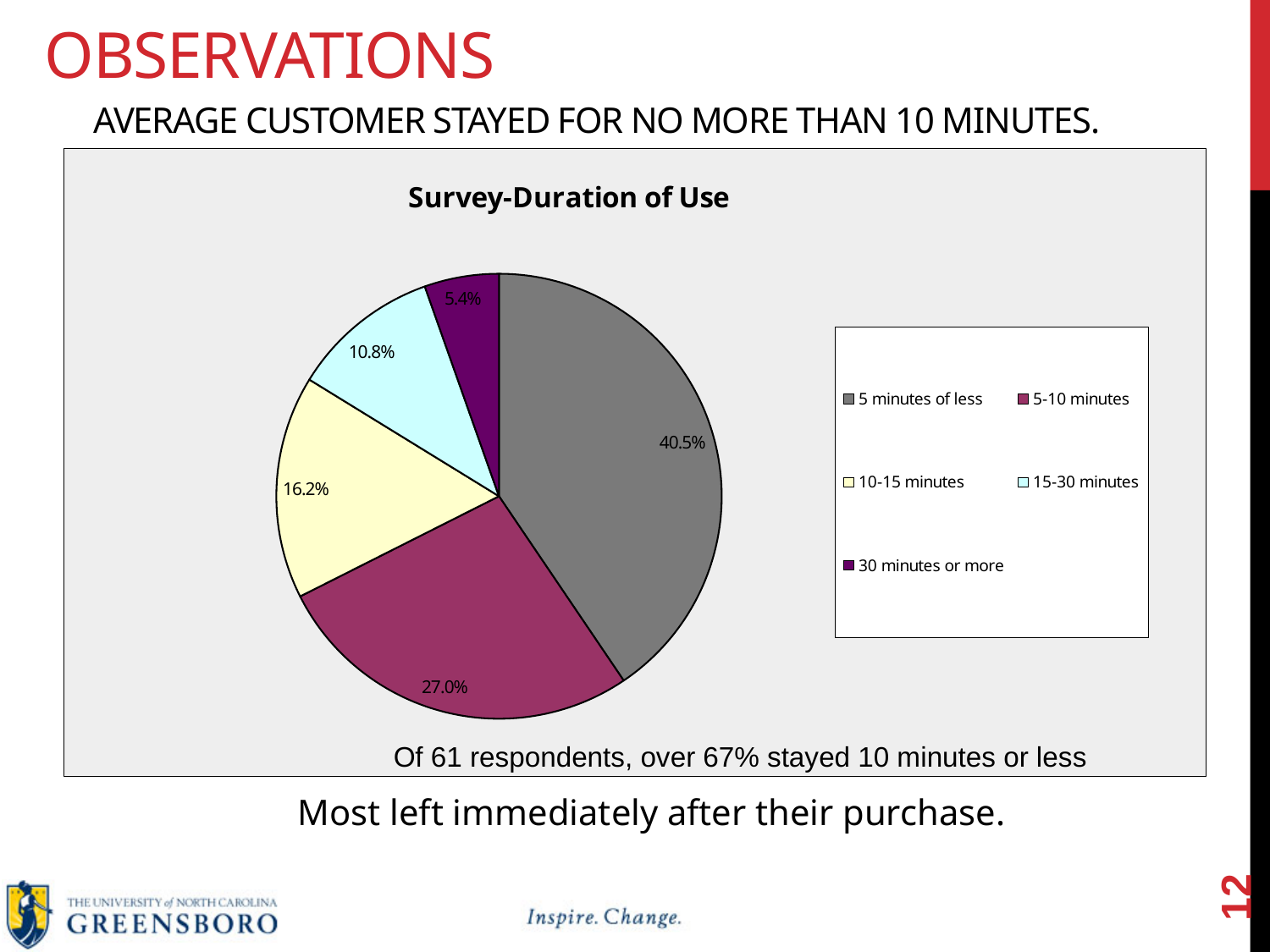
Which slice is larger, "10-15 minutes" or "15-30 minutes"? 10-15 minutes How many categories does the legend list? 5 What kind of chart is shown on the slide? Pie chart Which category has the smallest slice of the pie? 30 minutes or more What share of the pie is the "10-15 minutes" slice? 16.2% What share of the pie is the "5 minutes of less" slice? 40.5% Which category has the largest slice of the pie? 5 minutes of less What share of the pie is the "15-30 minutes" slice? 10.8% What is the difference in percentage points between the "5 minutes of less" slice and the "5-10 minutes" slice? 13.5 What is the title of the chart? Survey-Duration of Use